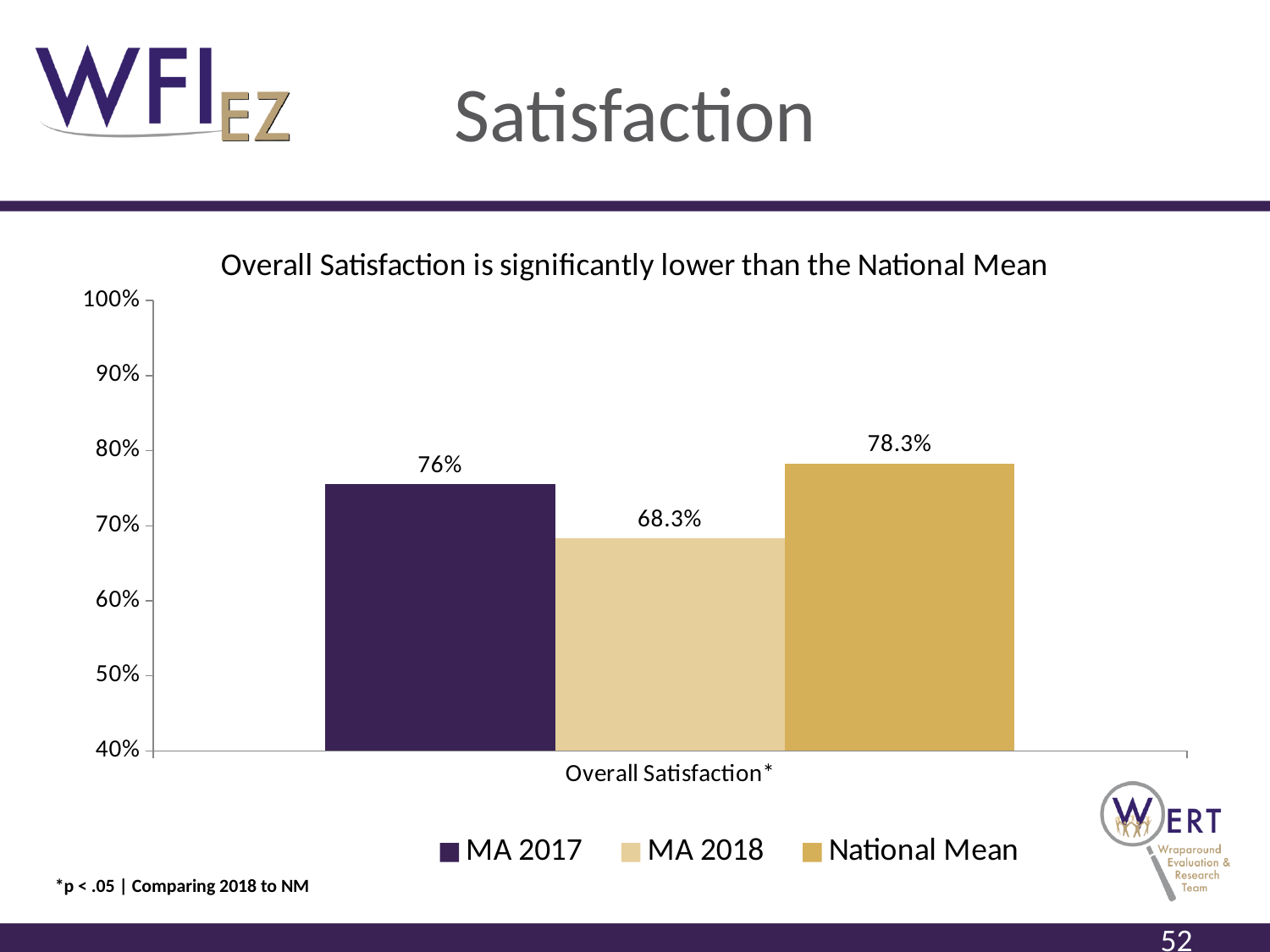
What is the value for MA 2018 for Overall Satisfaction? 68.3% Which series has the highest value for Overall Satisfaction? National Mean Which series has the lowest value for Overall Satisfaction? MA 2018 What is the value for MA 2017 for Overall Satisfaction? 76% Which is larger for Overall Satisfaction, MA 2017 or National Mean? National Mean What kind of chart is shown on the slide? Bar chart How many series does the legend list? 3 What is the value for National Mean for Overall Satisfaction? 78.3% What is the title of the chart? Overall Satisfaction is significantly lower than the National Mean What is the difference between the National Mean and MA 2018 values for Overall Satisfaction? 10 percentage points Is the value for MA 2018 greater or less than 70%? less What is the difference between the MA 2017 and MA 2018 values for Overall Satisfaction? 7.7 percentage points